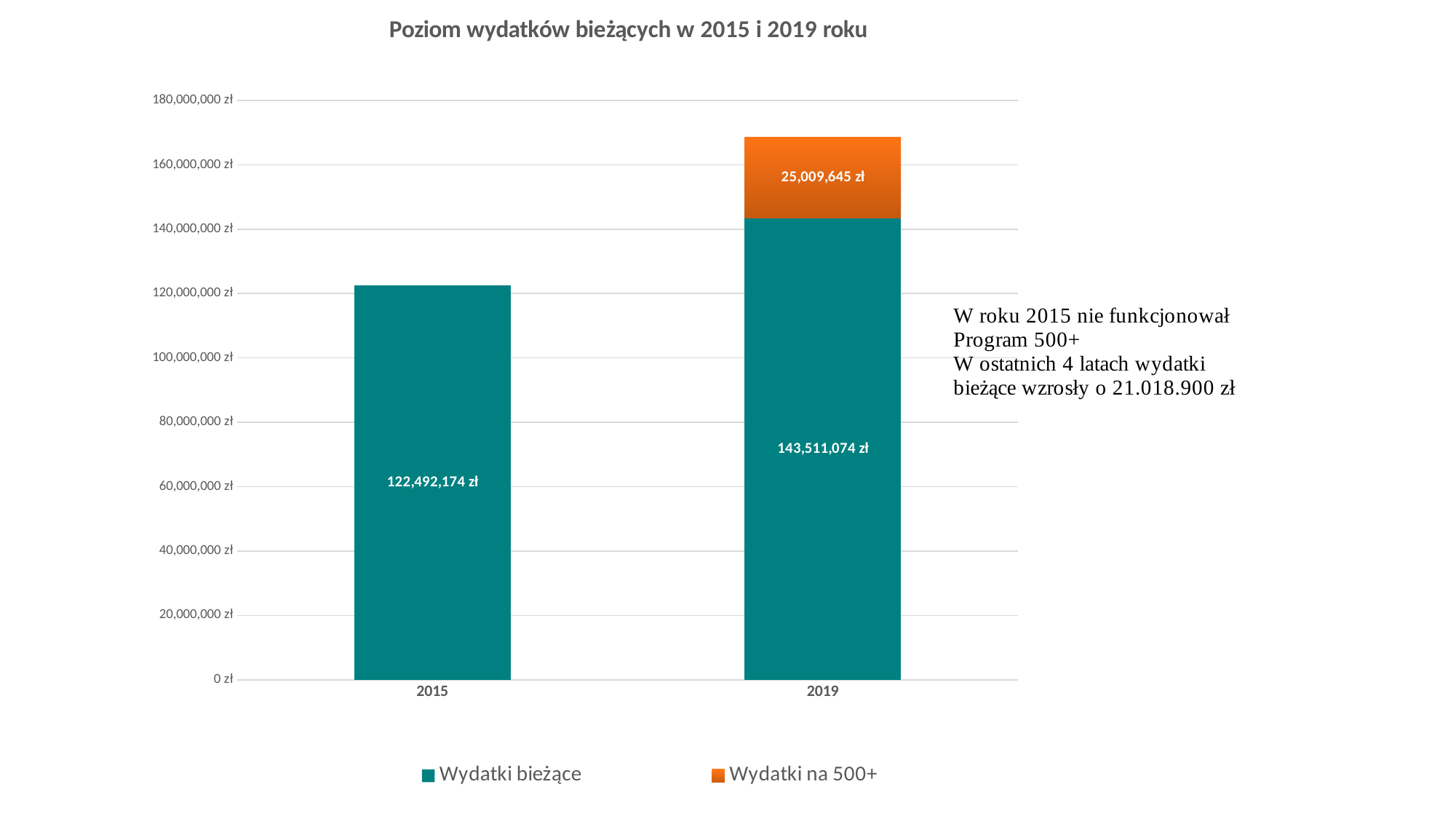
What is the value of Wydatki bieżące for 2015? 122,492,174 zł By how much did Wydatki bieżące in 2019 exceed Wydatki bieżące in 2015? 21,018,900 zł What kind of chart is shown on the slide? Stacked bar chart How many series does the legend list? 2 What is the value of Wydatki bieżące for 2019? 143,511,074 zł Is the total height of the 2019 bar greater or less than 160,000,000 zł? greater How many years are shown on the x axis? 2 Which year has the higher value for Wydatki bieżące? 2019 Which year has the lower value for Wydatki bieżące? 2015 What is the value of Wydatki na 500+ for 2019? 25,009,645 zł What is the title of the chart? Poziom wydatków bieżących w 2015 i 2019 roku What is the total of the stacked bar for 2019? 168,520,719 zł